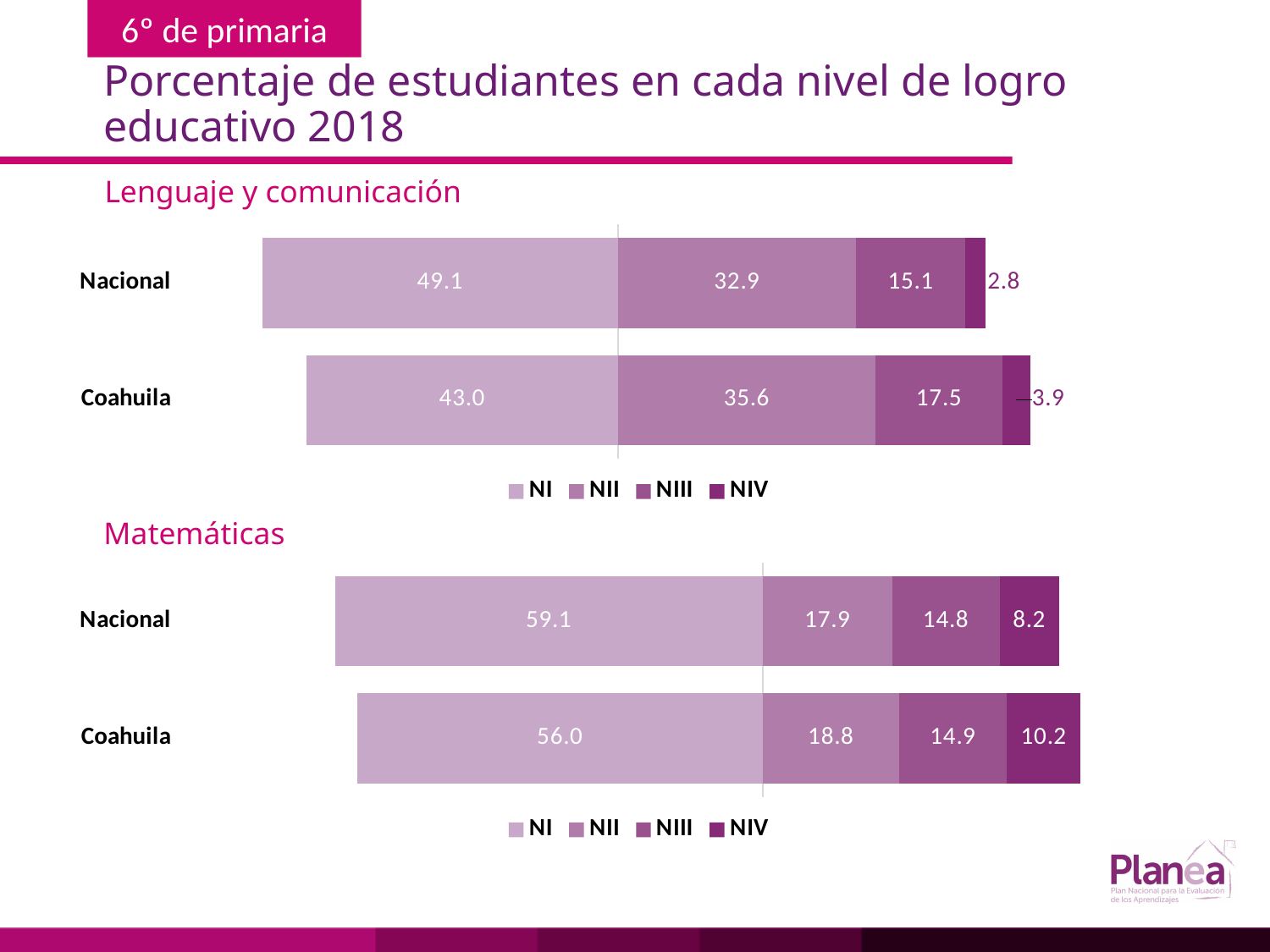
In the Lenguaje y comunicación chart, what is the NI value for Nacional? 49.1 In the Matemáticas chart, what is the difference between the NI values for Nacional and Coahuila? 3.1 In the Lenguaje y comunicación chart, what is the NIV value for Coahuila? 3.9 How many series does the legend of the Matemáticas chart list? 4 What kind of chart is the Lenguaje y comunicación chart? Stacked bar chart In the Lenguaje y comunicación chart, which is larger: the NI value for Nacional or for Coahuila? Nacional In the Matemáticas chart, what is the NII value for Coahuila? 18.8 In the Lenguaje y comunicación chart, which level has the lowest value for Nacional? NIV In the Matemáticas chart, which is larger: the NIV value for Coahuila or for Nacional? Coahuila In the Lenguaje y comunicación chart, what is the difference between the NIII values for Coahuila and Nacional? 2.4 In the Matemáticas chart, which level has the highest value for Coahuila? NI In the Matemáticas chart, what is the NIV value for Nacional? 8.2